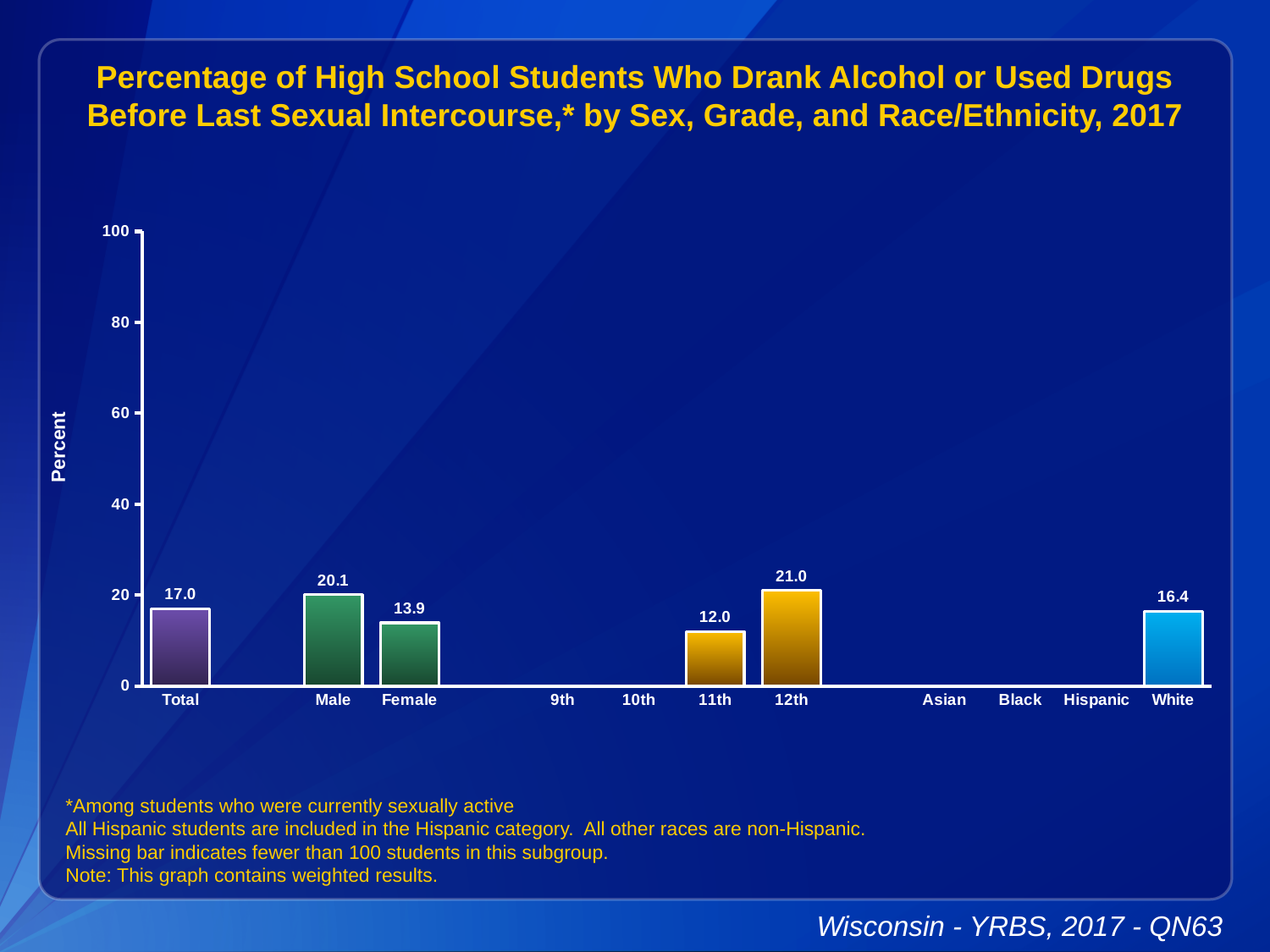
What is the value for 12th grade? 21.0 What is the difference between the Male and Female values? 6.2 Which is larger, the value for 11th grade or the value for 12th grade? 12th What is the value for Total? 17.0 Is the value for Female greater or less than 20? less What is the value for Male? 20.1 Which category has the highest value among the plotted bars? 12th What kind of chart is shown on the slide? bar chart What is the label on the y axis? Percent What is the value for White? 16.4 Which category has the lowest value among the plotted bars? 11th How many categories have a bar plotted on the chart? 6